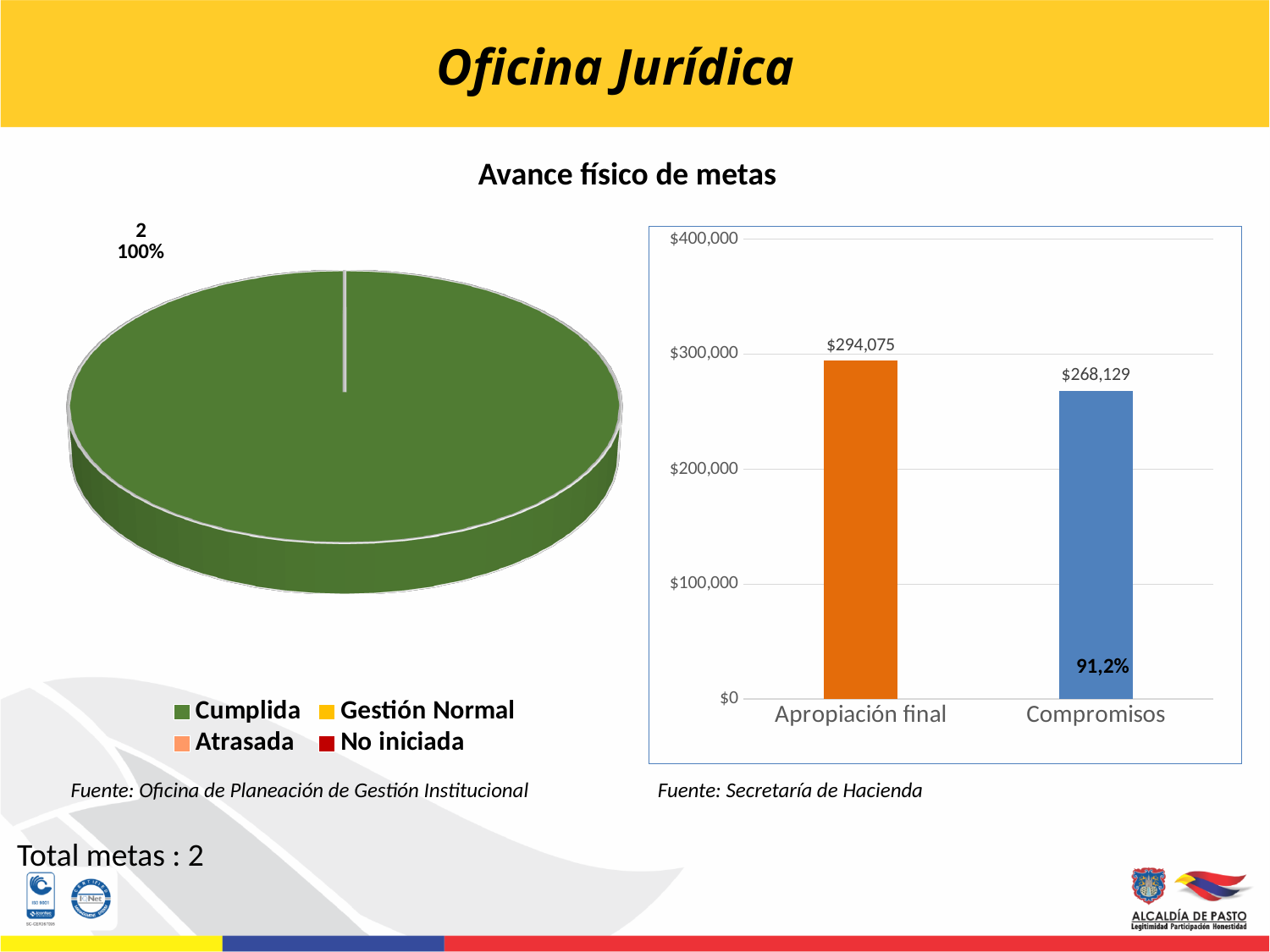
On the bar chart on the right, is the value for Compromisos greater or less than $300,000? less On the bar chart on the right, which category has the higher value, Apropiación final or Compromisos? Apropiación final What kind of chart is the chart on the right side of the slide? Bar chart On the bar chart on the right, what is the difference between Apropiación final and Compromisos? $25,946 On the pie chart on the left, what share does the Cumplida slice represent? 100% On the bar chart on the right, what is the value for Apropiación final? $294,075 On the bar chart on the right, what is the value for Compromisos? $268,129 What kind of chart is the chart on the left side of the slide? Pie chart What is the title shown above the charts on the slide? Avance físico de metas How many entries does the legend of the pie chart on the left list? 4 On the bar chart on the right, how many categories are plotted? 2 On the bar chart on the right, what percentage label is shown on the Compromisos bar? 91,2%